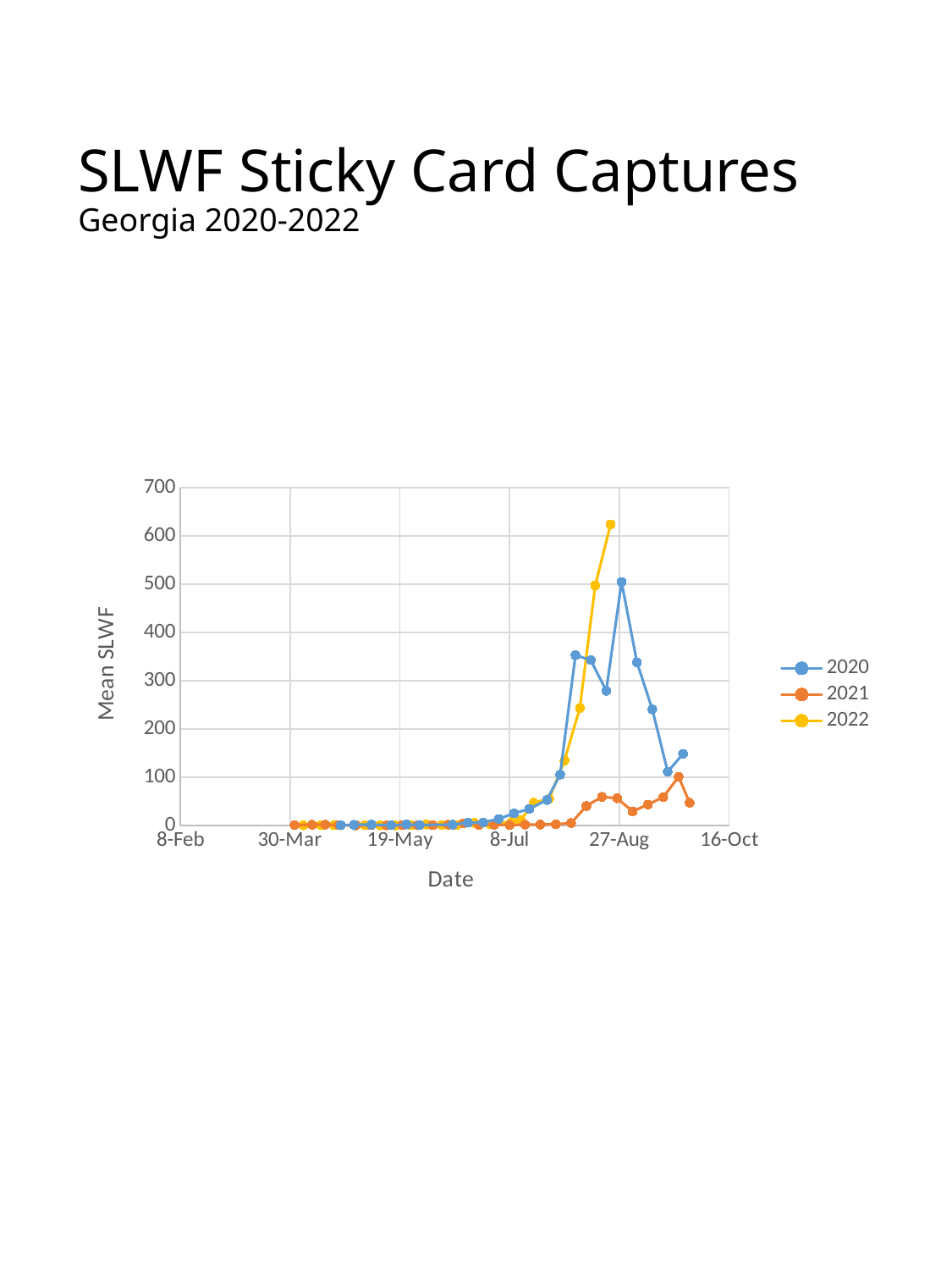
Is the peak value for the 2022 series greater or less than 600? greater Which series has the lowest peak value on the chart? 2021 What kind of chart is shown on the slide? line chart Which years are listed in the chart legend? 2020, 2021, 2022 Do the values for the 2022 series rise or fall between 8-Jul and 27-Aug? rise Which series has the larger peak value, 2020 or 2022? 2022 How many series does the legend list? 3 What is the label of the vertical axis? Mean SLWF Is the peak value for the 2020 series greater or less than 400? greater What is the highest value shown on the vertical axis? 700 Which series reaches the highest peak value on the chart? 2022 Is the peak value for the 2021 series greater or less than 200? less